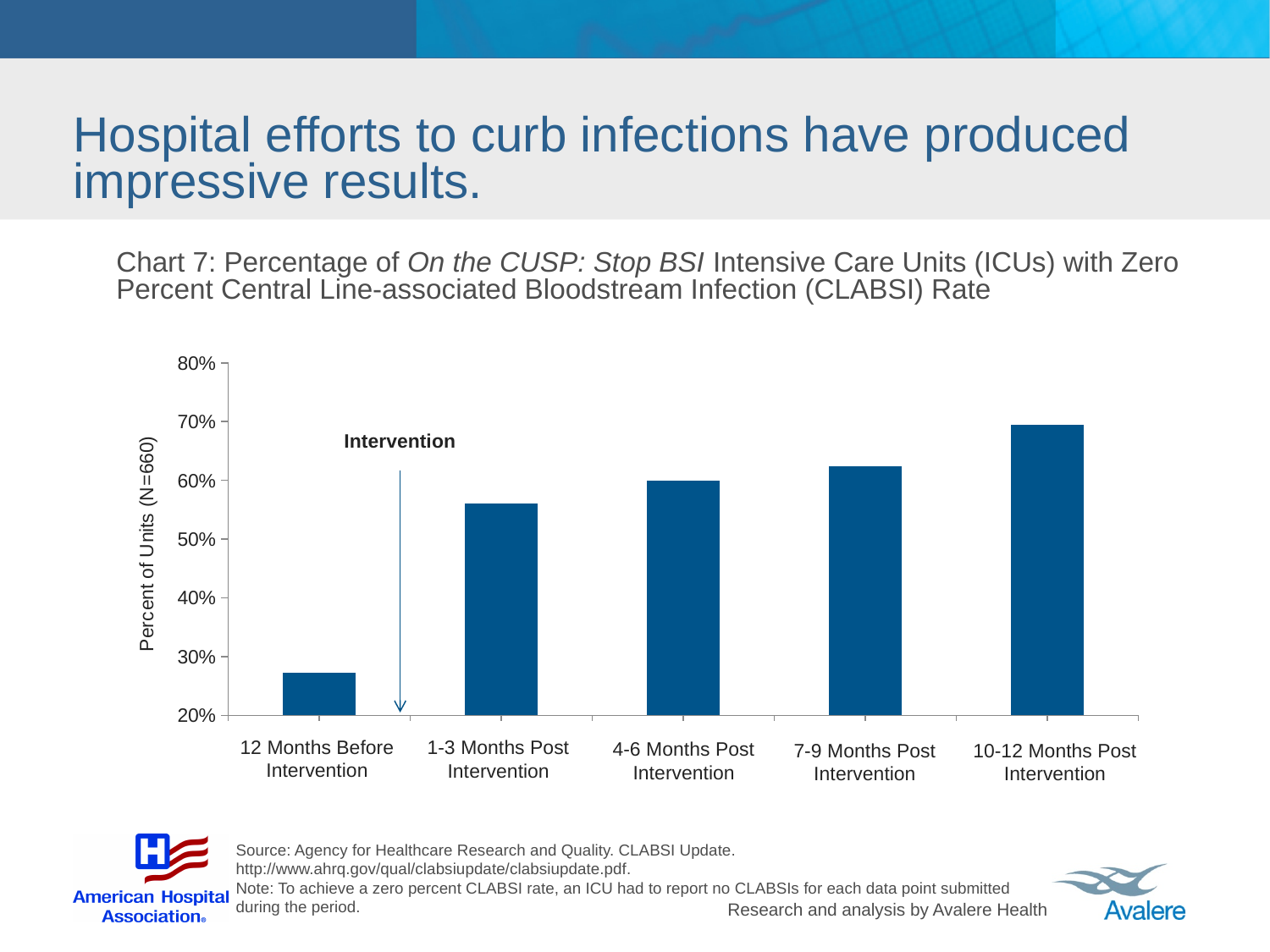
Is the value for 12 Months Before Intervention greater or less than 30%? less What kind of chart is shown on the slide? bar chart Which category has the highest percentage of units? 10-12 Months Post Intervention What is the label on the y axis of the chart? Percent of Units (N=660) Is the value for 7-9 Months Post Intervention greater or less than 60%? greater Which is larger: the value for 12 Months Before Intervention or the value for 1-3 Months Post Intervention? 1-3 Months Post Intervention How many categories are shown on the x axis of the chart? 5 Do the values rise or fall moving from left to right along the x axis? rise Which category has the lowest percentage of units? 12 Months Before Intervention Is the value for 1-3 Months Post Intervention greater or less than 50%? greater What does the annotation with the downward arrow between the first and second bars say? Intervention